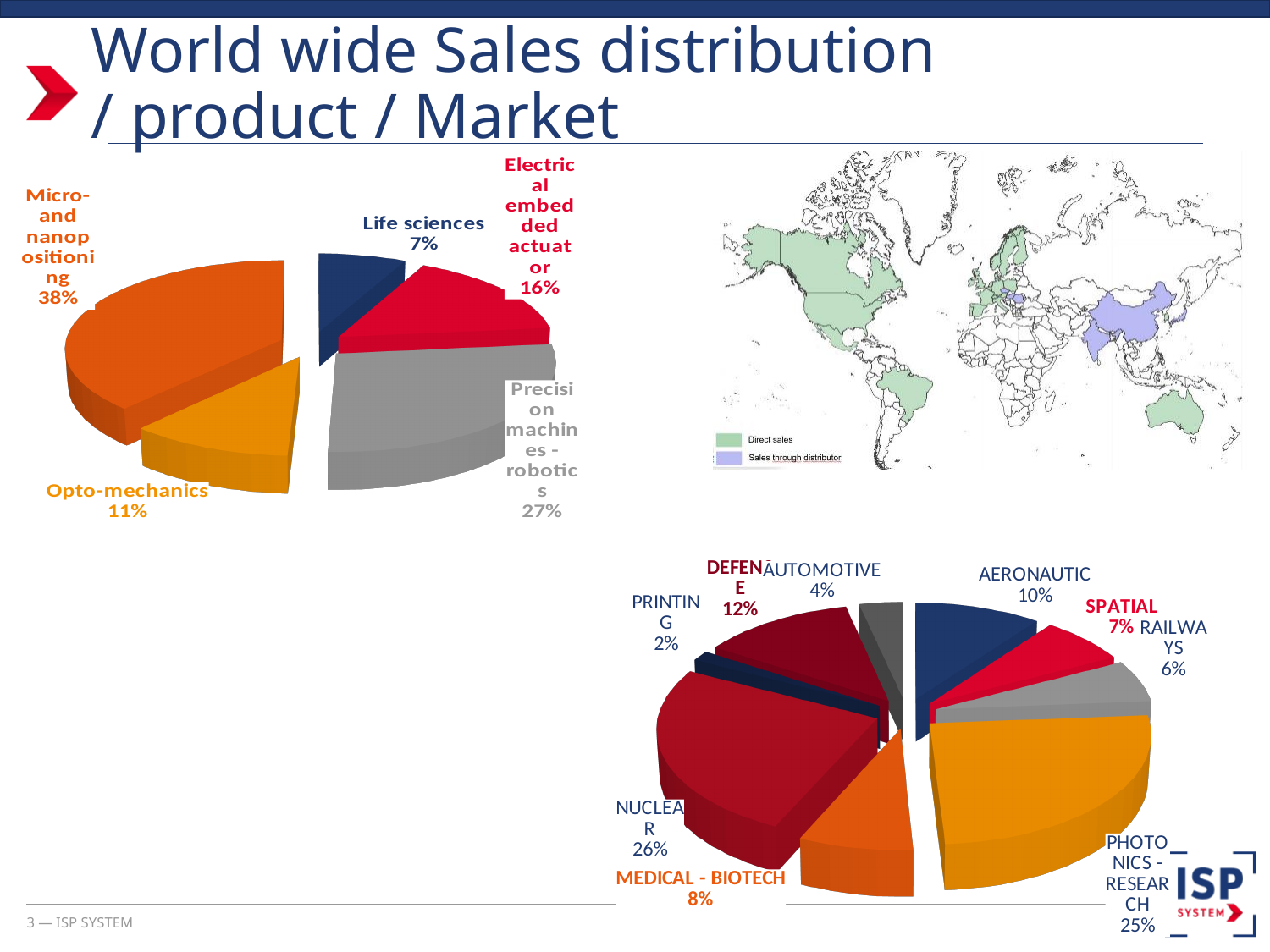
In the pie chart at the bottom right of the slide, which category has the smallest share? Printing In the pie chart at the bottom right of the slide, which is larger, Defense or Aeronautic? Defense In the pie chart at the bottom right of the slide, what share is shown for Photonics - Research? 25% In the pie chart on the left of the slide, how many categories are shown? 5 In the pie chart on the left of the slide, what share is shown for Micro- and nanopositioning? 38% In the pie chart on the left of the slide, what is the difference between the shares of Electrical embedded actuator and Opto-mechanics? 5% In the pie chart at the bottom right of the slide, how many categories are shown? 9 In the pie chart on the left of the slide, which category has the largest share? Micro- and nanopositioning In the pie chart on the left of the slide, which category has the smallest share? Life sciences In the pie chart on the left of the slide, what share is shown for Precision machines - robotics? 27% What type of chart is used at the bottom right of the slide? Pie chart In the pie chart at the bottom right of the slide, what share is shown for Nuclear? 26%